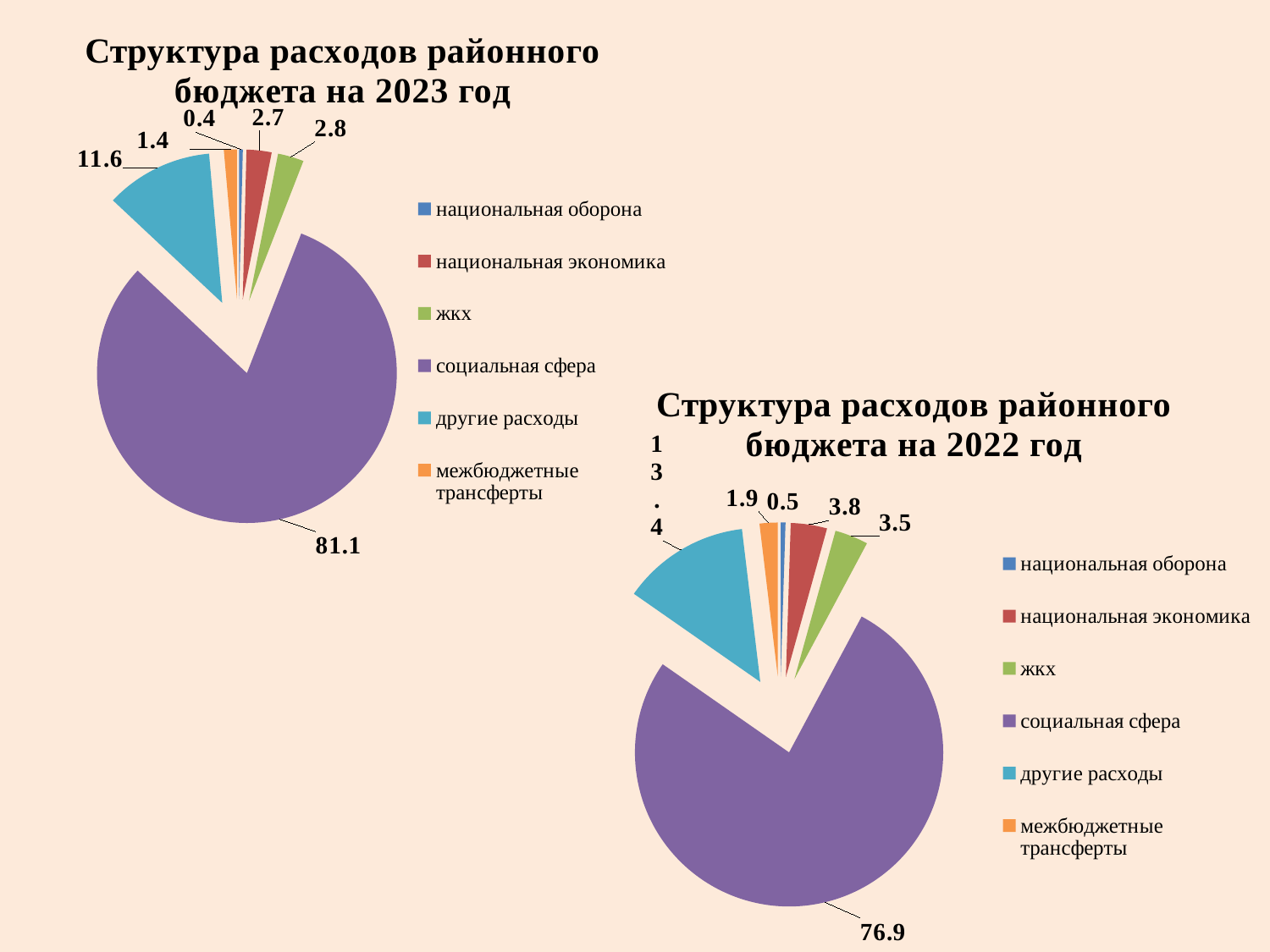
In the chart titled 'Структура расходов районного бюджета на 2023 год', what is the value for социальная сфера? 81.1 In the chart titled 'Структура расходов районного бюджета на 2023 год', what is the value for жкх? 2.8 In the chart titled 'Структура расходов районного бюджета на 2022 год', which is larger: национальная экономика or жкх? национальная экономика What is the difference between the value for социальная сфера in the 2023 chart and the value for социальная сфера in the 2022 chart? 4.2 How many categories does the legend of the chart titled 'Структура расходов районного бюджета на 2022 год' list? 6 In the chart titled 'Структура расходов районного бюджета на 2022 год', which category has the largest value? социальная сфера In the chart titled 'Структура расходов районного бюджета на 2023 год', which category has the smallest value? национальная оборона In the chart titled 'Структура расходов районного бюджета на 2022 год', what is the value for другие расходы? 13.4 In the chart titled 'Структура расходов районного бюджета на 2022 год', what is the value for межбюджетные трансферты? 1.9 What type of chart is the chart titled 'Структура расходов районного бюджета на 2023 год'? Pie chart In the chart titled 'Структура расходов районного бюджета на 2022 год', what colour represents другие расходы? Teal (light blue) In the chart titled 'Структура расходов районного бюджета на 2023 год', what is the difference between другие расходы and межбюджетные трансферты? 10.2